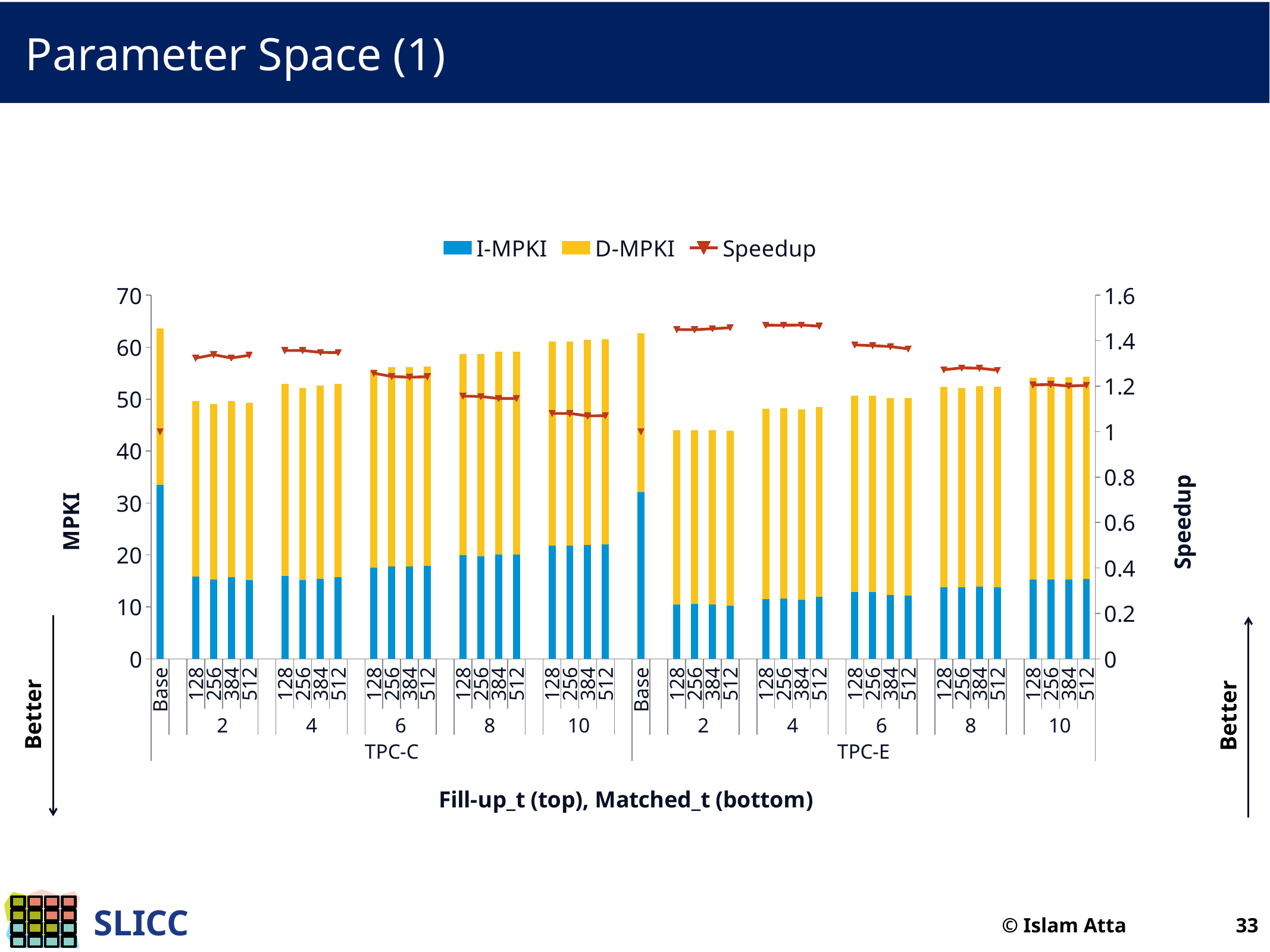
What is the title of the right vertical axis? Speedup How many series does the legend list? 3 Which has the higher Speedup at Matched_t = 2: TPC-C or TPC-E? TPC-E Is the Speedup for TPC-C with Matched_t = 10 greater or less than 1.2? less How many Fill-up_t values are plotted for each Matched_t group? 4 What kind of chart is shown on the slide? Stacked bar chart with a line (Speedup) Is the total MPKI of the TPC-C Base bar greater or less than 60? greater Which Matched_t group in TPC-E has the highest Speedup? 4 What is the title of the left vertical axis? MPKI Is the Speedup for TPC-E with Matched_t = 4 greater or less than 1.4? greater How many Matched_t groups (excluding Base) are shown for TPC-C? 5